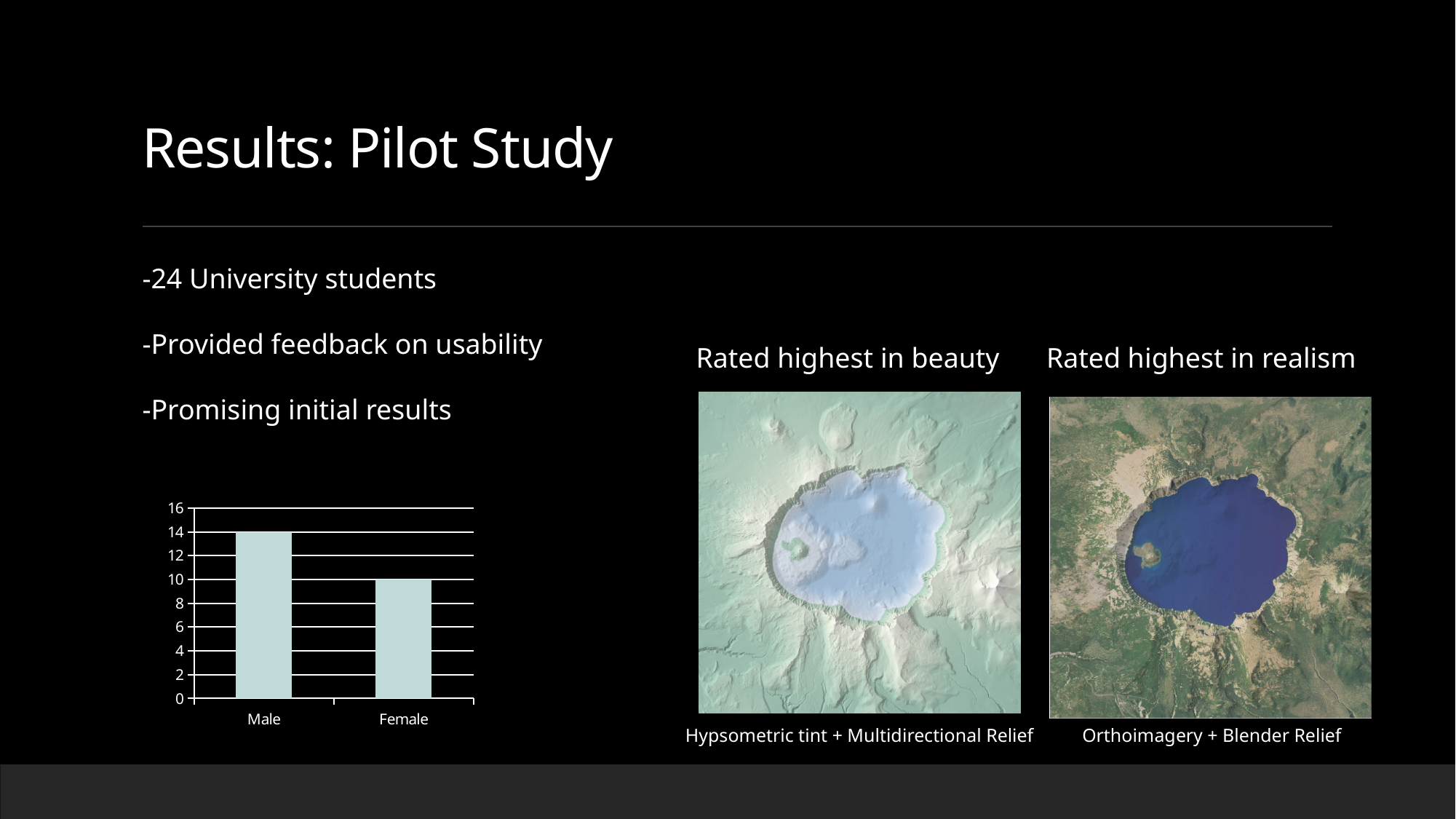
Is the value for Female greater or less than 12? less What are the category labels on the x axis of the bar chart? Male, Female What kind of chart is shown on the slide? bar chart Which category has the lowest value in the bar chart? Female How many categories does the bar chart show? 2 Which category has the highest value in the bar chart? Male What is the difference between the Male and Female values in the bar chart? 4 What is the maximum value shown on the vertical axis of the bar chart? 16 Which is larger in the bar chart, the value for Male or the value for Female? Male What is the value for Male in the bar chart? 14 Is the value for Male greater or less than 12? greater What is the value for Female in the bar chart? 10